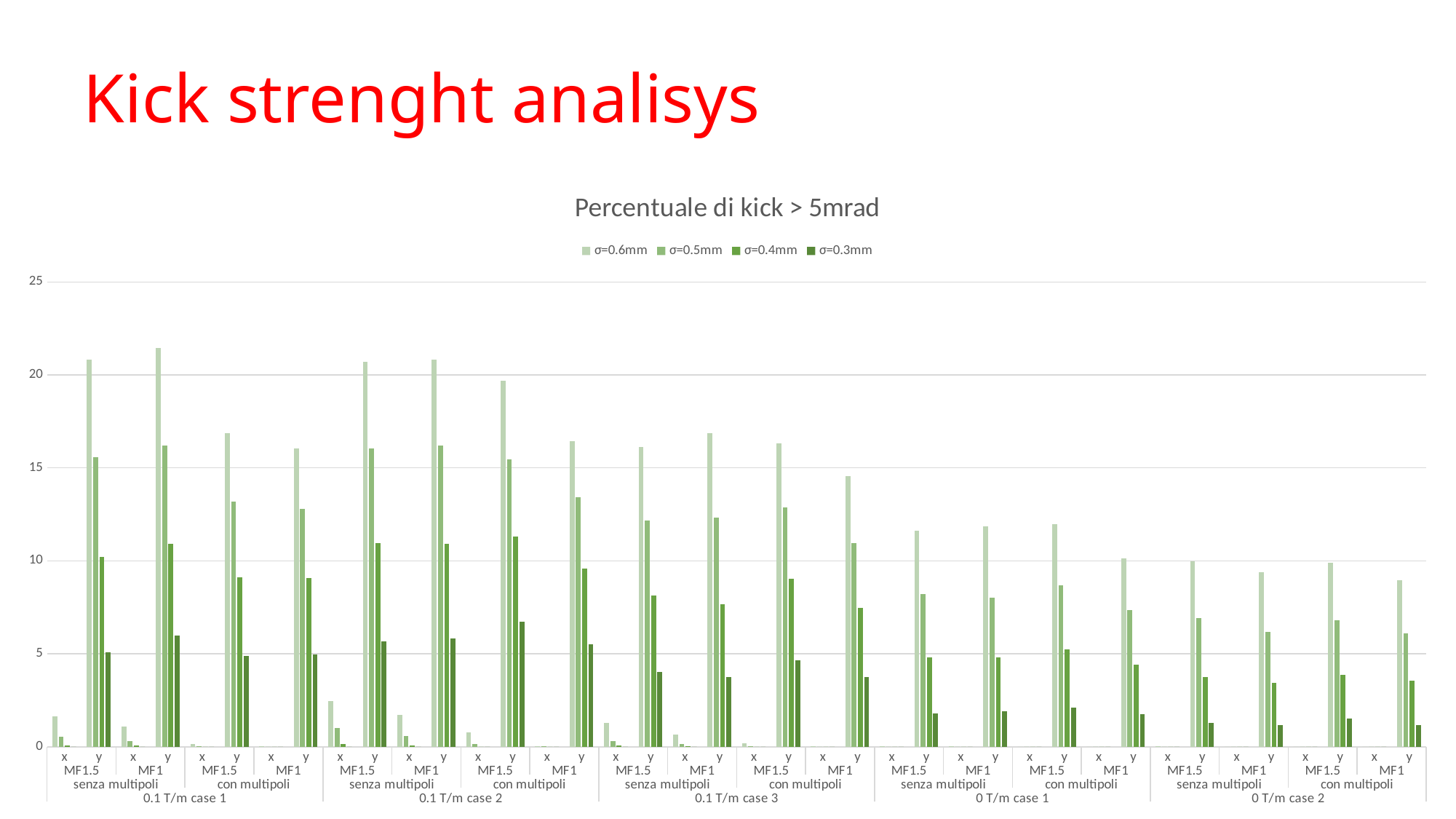
Is the σ=0.3mm value for y, MF1.5, senza multipoli, 0.1 T/m case 3 greater or less than 5? less For σ=0.6mm, y, MF1, senza multipoli: which is larger, 0.1 T/m case 1 or 0 T/m case 1? 0.1 T/m case 1 Is the σ=0.6mm value for y, MF1, senza multipoli, 0.1 T/m case 1 greater or less than 20? greater Which series does the darkest green colour represent in the legend? σ=0.3mm Is the σ=0.6mm value for y, MF1, con multipoli, 0 T/m case 2 greater or less than 10? less For σ=0.6mm, MF1.5, senza multipoli, 0.1 T/m case 1: which is larger, x or y? y How many top-level case groups (e.g. '0.1 T/m case 1') are shown along the x axis? 5 What is the title of the chart? Percentuale di kick > 5mrad Which series generally has the tallest bars across the chart? σ=0.6mm How many series does the legend list? 4 What kind of chart is shown on the slide? bar chart